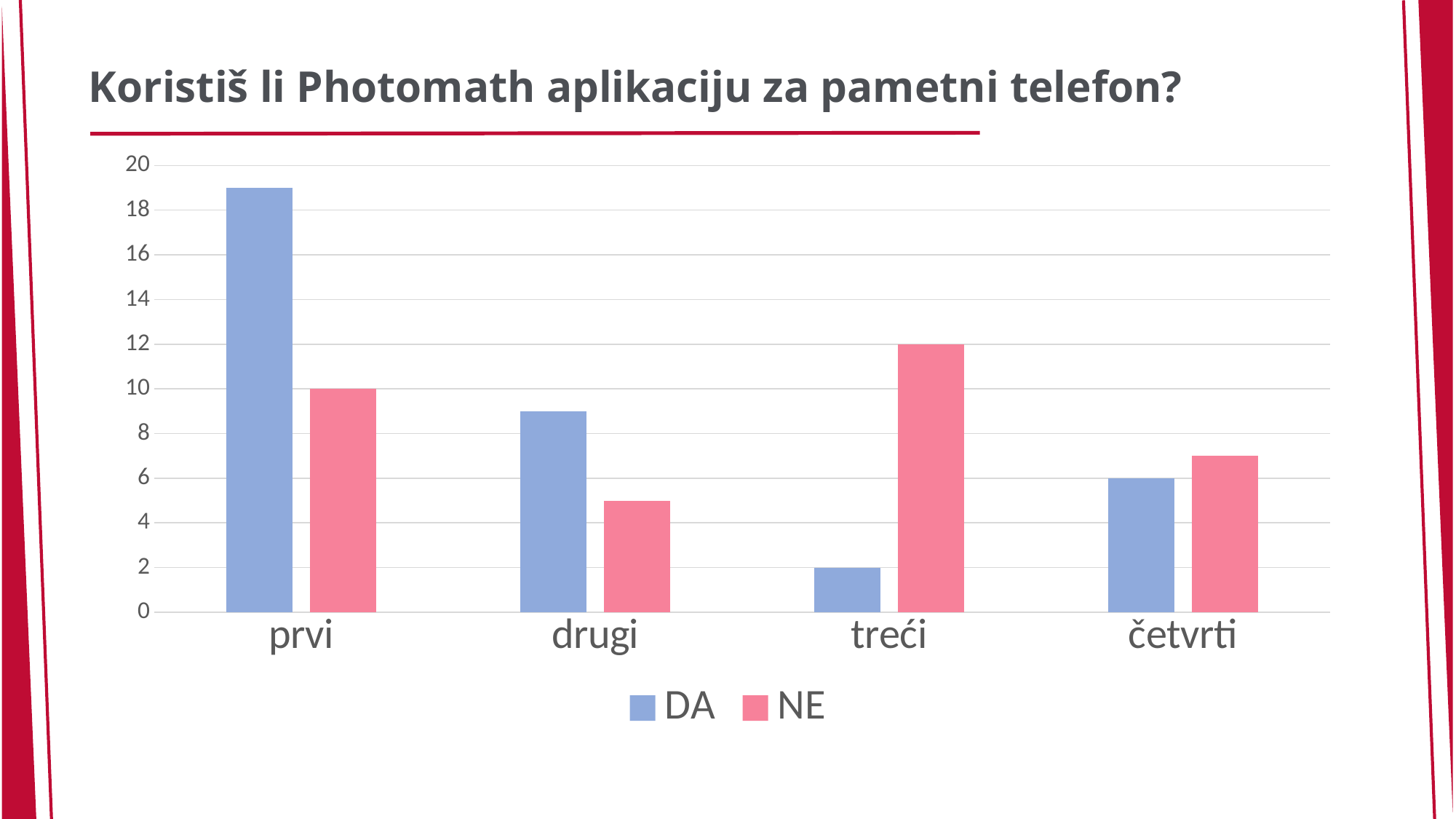
What is the difference between the NE and DA values for treći? 10 What is the DA value for četvrti? 6 Is the NE value for drugi greater or less than 4? greater Is the DA value for prvi greater or less than 18? greater What is the DA value for treći? 2 How many categories are shown on the x axis? 4 What is the NE value for prvi? 10 Which category has the highest NE value? treći Which category has the highest DA value? prvi How many series does the legend list? 2 What kind of chart is shown on the slide? bar chart What is the NE value for treći? 12